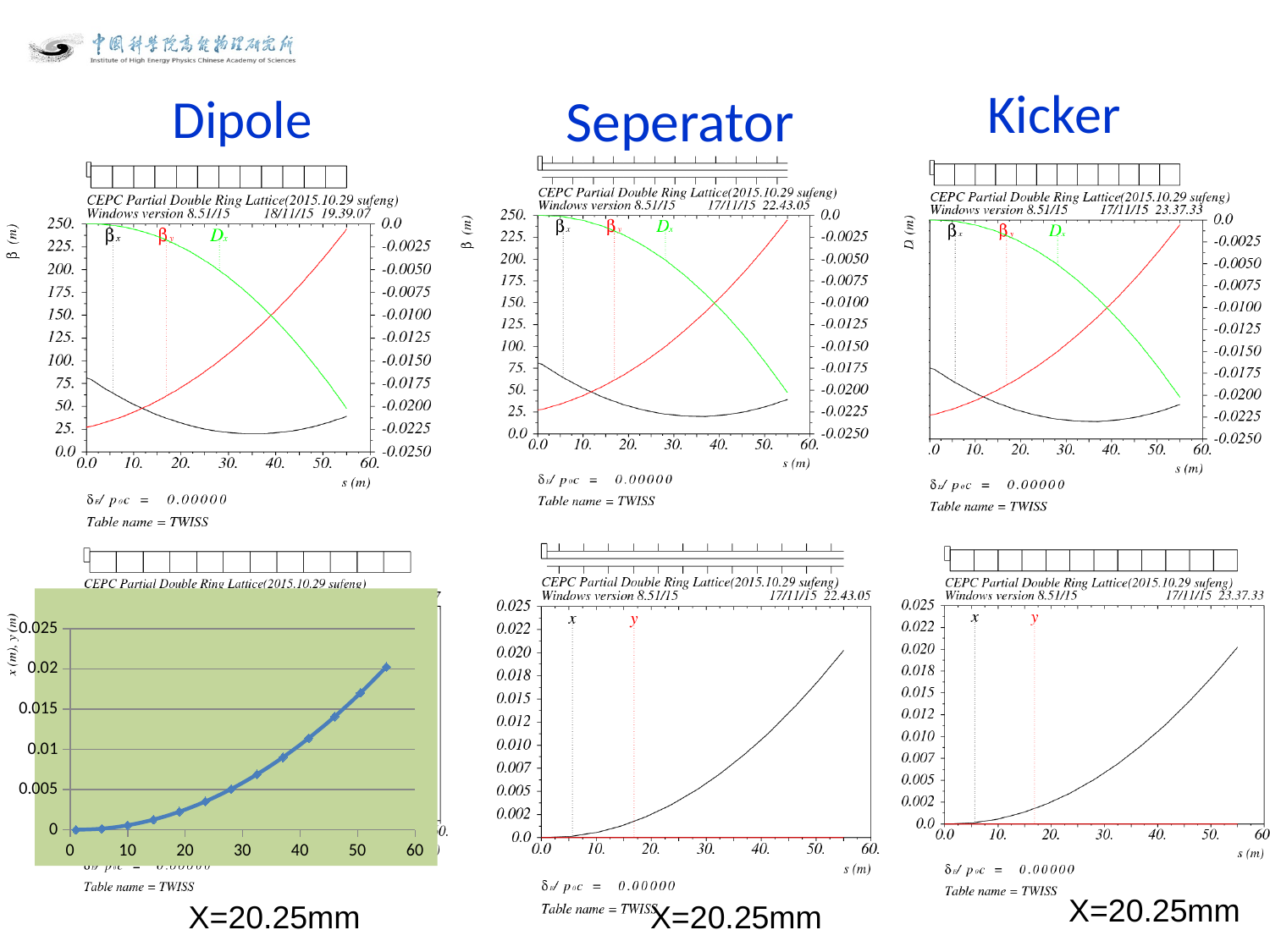
What kind of chart is the green-background chart at the bottom left under Dipole? line chart In the green-background chart at the bottom left under Dipole, is the value at x=55 greater or less than 0.015? greater In the top chart under Dipole, does the green Dx curve rise or fall as s increases? fall In the green-background chart at the bottom left under Dipole, is the value at x=20 greater or less than 0.005? less In the bottom chart under Kicker, does the black x curve rise or fall as s increases? rise In the green-background chart at the bottom left under Dipole, do the values rise or fall as the x axis increases? rise How many series are labelled in the top chart under Dipole? 3 In the green-background chart at the bottom left under Dipole, what is the highest value shown on the y axis? 0.025 In the green-background chart at the bottom left under Dipole, is the value at x=30 greater or less than 0.01? less In the green-background chart at the bottom left under Dipole, is the value at x=55 larger or smaller than the value at x=10? larger In the top chart under Dipole, what is the highest value shown on the left y axis? 250.